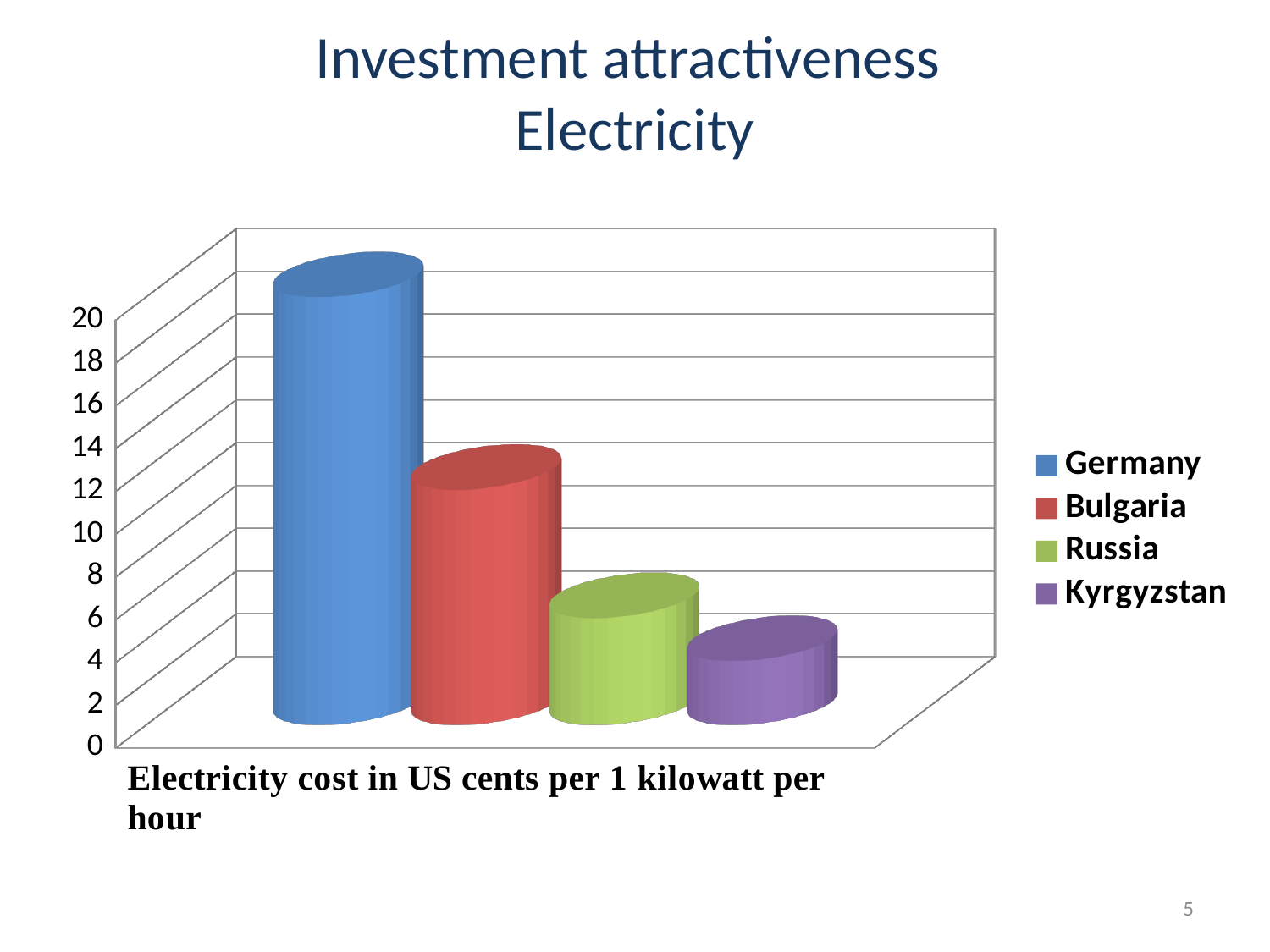
What is the axis label shown below the chart? Electricity cost in US cents per 1 kilowatt per hour Is the value for Germany greater or less than 14? greater How many series does the legend list? 4 Which has a higher electricity cost, Germany or Bulgaria? Germany Is the value for Bulgaria greater or less than 8? greater Is the value for Russia greater or less than 10? less Do the bar values rise or fall from left to right across the chart? fall Which country has the highest electricity cost in the chart? Germany Which has a higher electricity cost, Russia or Kyrgyzstan? Russia What kind of chart is shown on the slide? bar chart Which country has the lowest electricity cost in the chart? Kyrgyzstan How many bars are plotted in the chart? 4